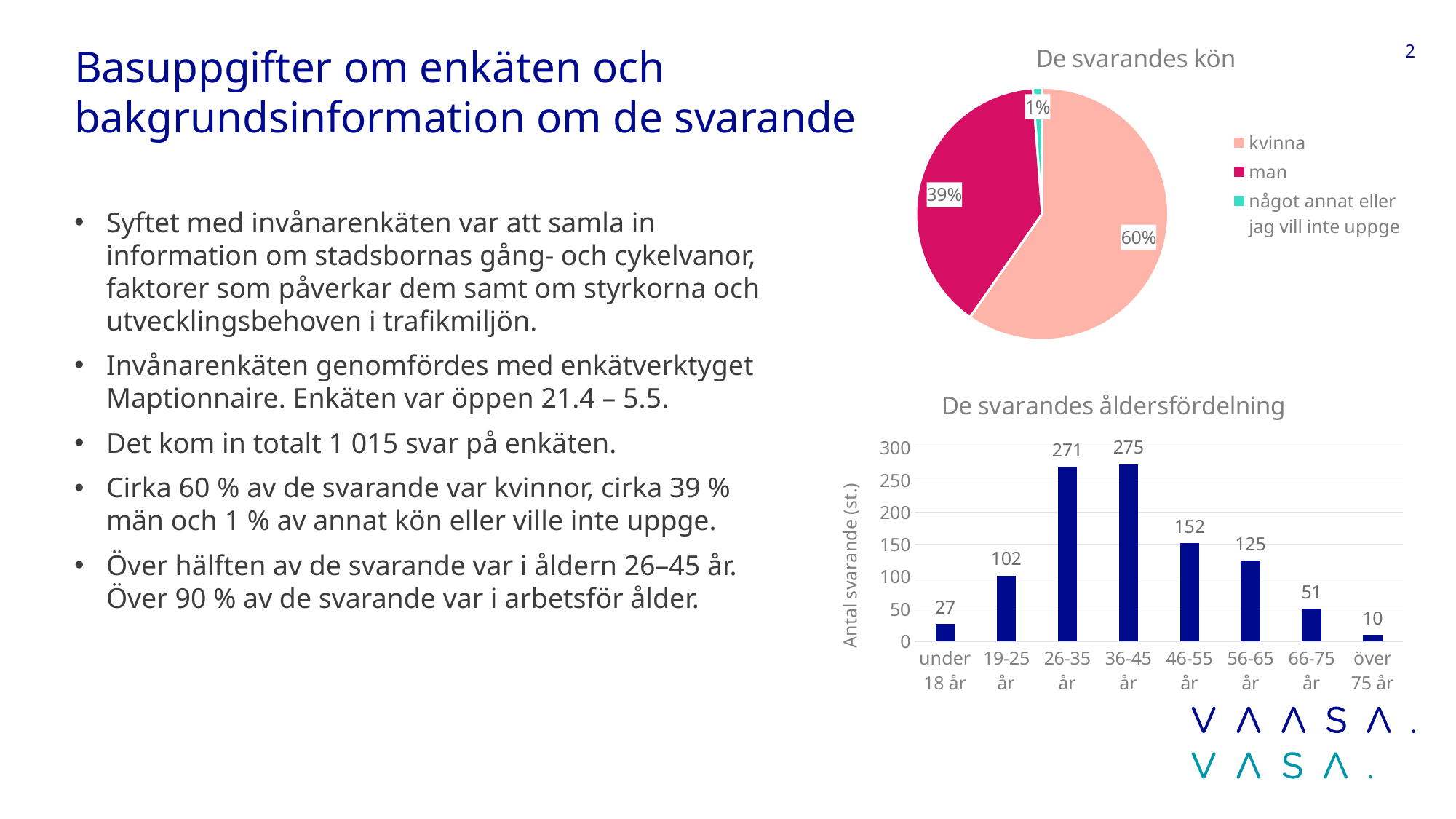
In the chart 'De svarandes åldersfördelning', what is the difference between the values for '46-55 år' and '56-65 år'? 27 In the chart 'De svarandes kön', what share of respondents are 'man'? 39% What kind of chart is 'De svarandes åldersfördelning'? bar chart What kind of chart is 'De svarandes kön'? pie chart In the chart 'De svarandes kön', what share of respondents are 'kvinna'? 60% How many age categories are shown in the chart 'De svarandes åldersfördelning'? 8 In the chart 'De svarandes åldersfördelning', what is the value for '66-75 år'? 51 In the chart 'De svarandes åldersfördelning', which is larger: the value for '19-25 år' or the value for '66-75 år'? 19-25 år In the chart 'De svarandes åldersfördelning', which age group has the highest number of respondents? 36-45 år In the chart 'De svarandes åldersfördelning', what is the value for '26-35 år'? 271 In the chart 'De svarandes åldersfördelning', which age group has the lowest number of respondents? över 75 år How many entries does the legend of the chart 'De svarandes kön' list? 3